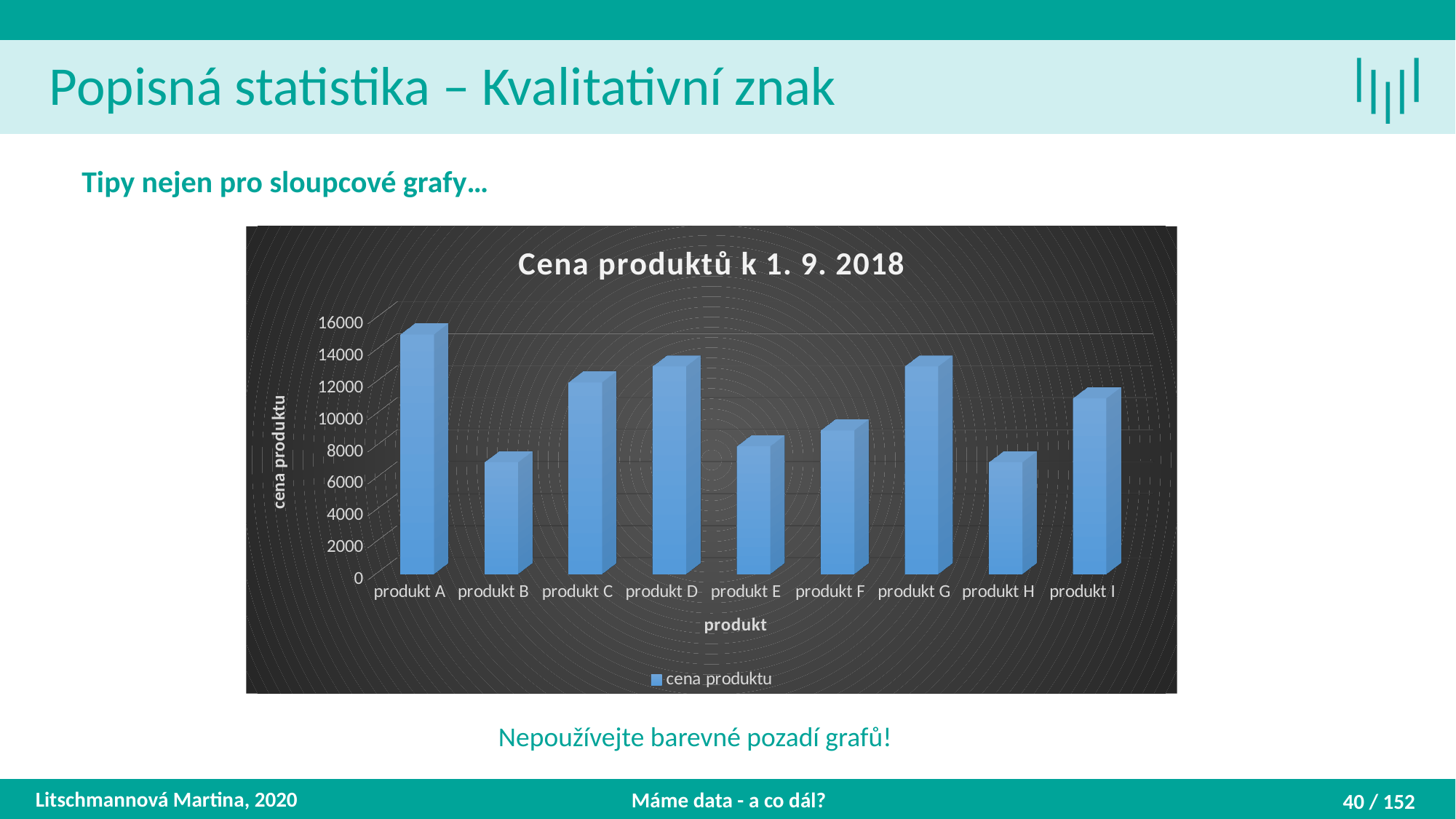
Is the value for produkt A greater or less than 12000? greater Is the value for produkt G greater or less than 10000? greater Is the value for produkt E greater or less than 10000? less How many products (categories) are shown on the x axis of the chart? 9 What is the label of the series shown in the chart legend? cena produktu How many series does the chart legend list? 1 What type of chart is shown on the slide? bar chart Which product has the highest price in the chart? produkt A What is the title of the chart? Cena produktů k 1. 9. 2018 Which has a larger value, produkt C or produkt E? produkt C Which has a larger value, produkt D or produkt H? produkt D